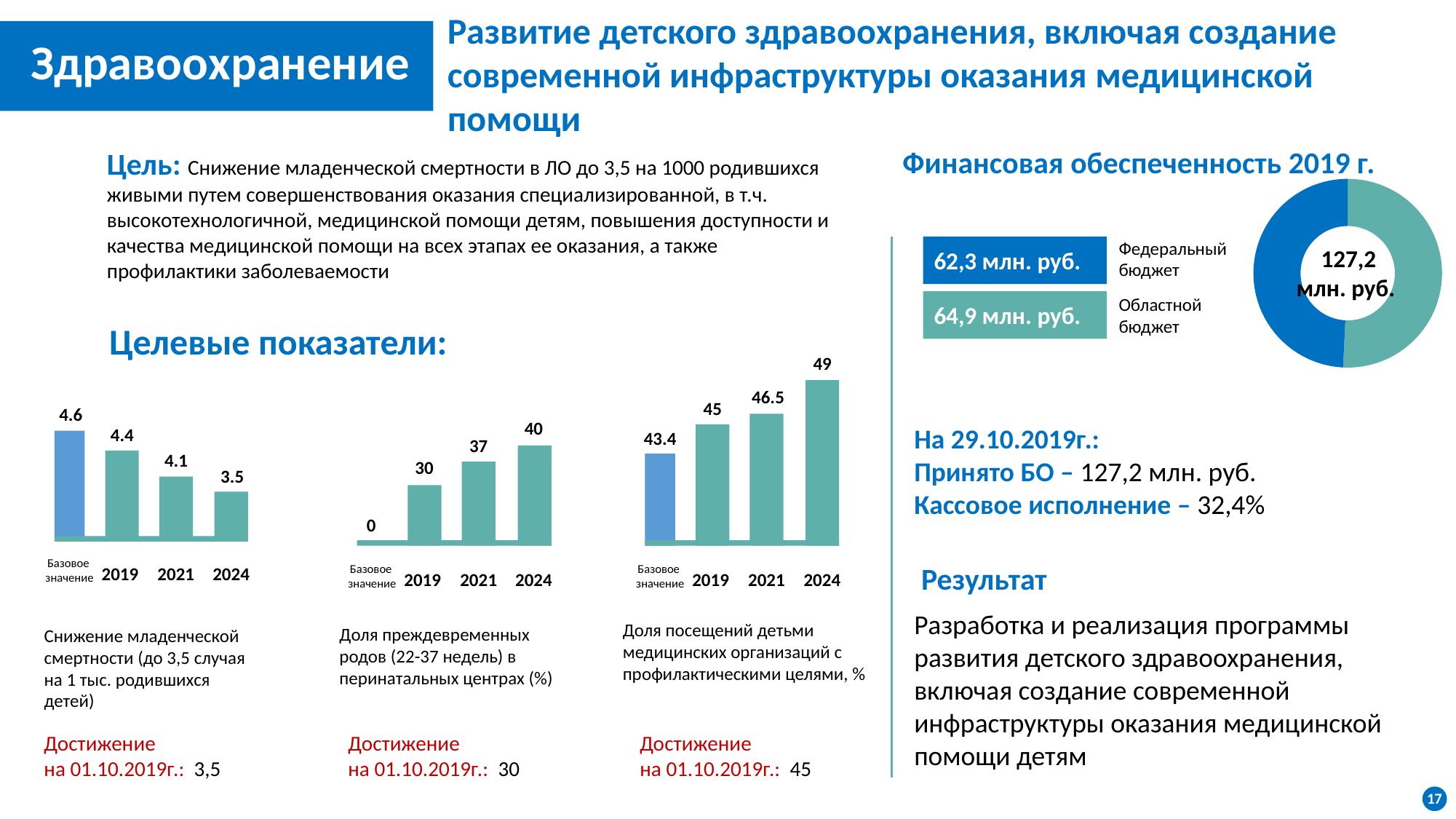
In the left bar chart (infant mortality reduction), what is the value for 2024? 3.5 In the right bar chart (share of children's preventive visits), what is the value for 2019? 45 In the right bar chart (share of children's preventive visits), which category has the highest value? 2024 What kind of chart is used for 'Финансовая обеспеченность 2019 г.'? donut (pie) chart In the left bar chart (infant mortality reduction), what is the difference between the 2019 value and the 2024 value? 0.9 In the middle bar chart (share of premature births in perinatal centres), what is the value for 2021? 37 In the donut chart 'Финансовая обеспеченность 2019 г.', what is the value for the regional budget (Областной бюджет)? 64,9 млн. руб. In the middle bar chart (share of premature births in perinatal centres), which category has the lowest value? Базовое значение In the left bar chart (infant mortality reduction), do the values rise or fall from the base value to 2024? fall In the right bar chart (share of children's preventive visits), what is the difference between the 2024 value and the base value? 5.6 In the left bar chart (infant mortality reduction), what is the value for the base value (Базовое значение)? 4.6